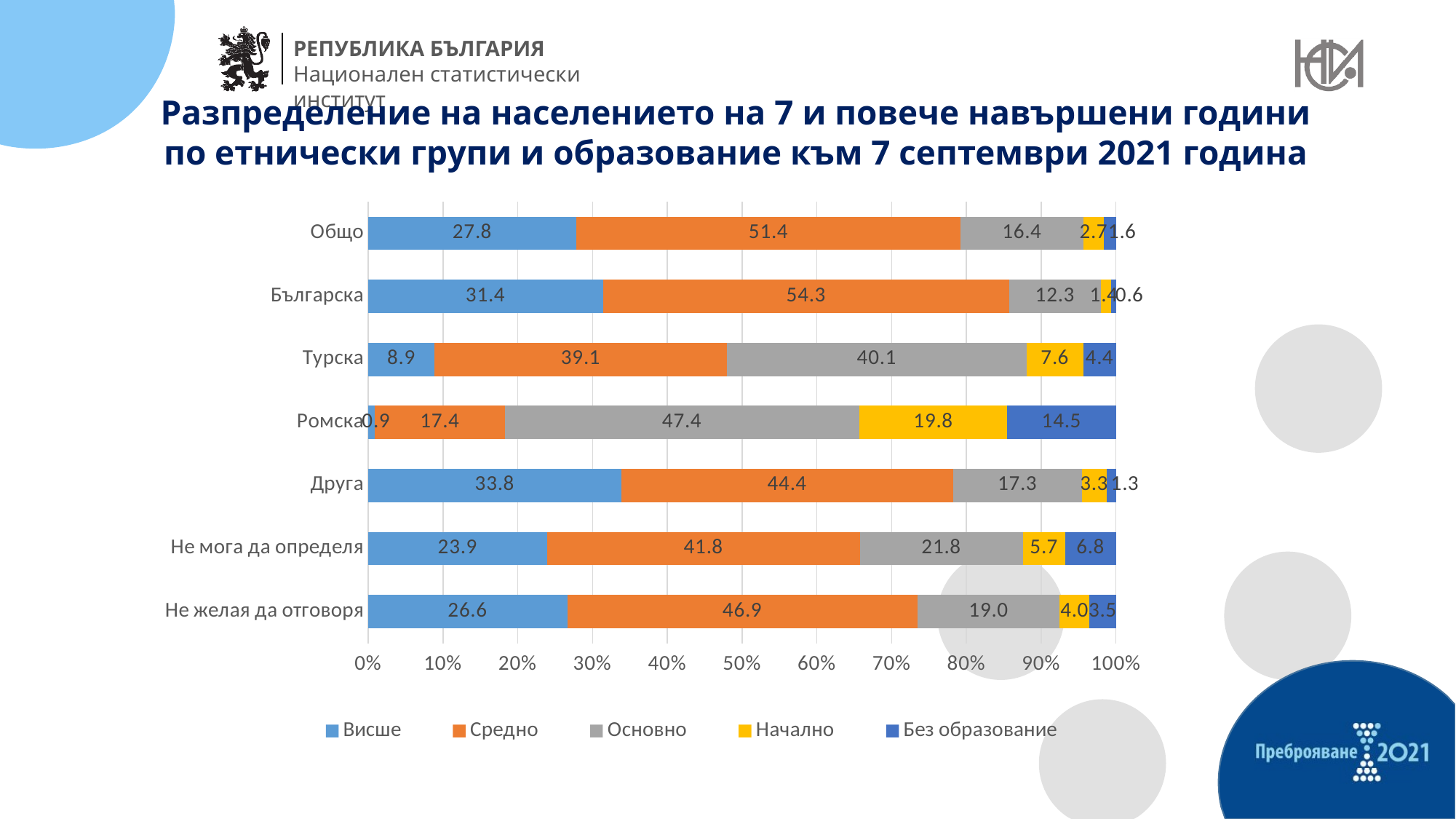
Which category has the highest value for Висше? Друга What is the difference between the Средно values for Българска and Турска? 15.2 Which is larger: the Начално value for Ромска or for Турска? Ромска How many categories are shown on the y axis? 7 How many series does the legend list? 5 Which series has the largest segment in the Ромска bar? Основно What kind of chart is shown on the slide? stacked bar chart Which category has the lowest value for Висше? Ромска Is the Висше value for Общо greater or less than 30%? less What is the value of Без образование for Не мога да определя? 6.8 What is the value of Висше for Турска? 8.9 What is the value of Основно for Ромска? 47.4